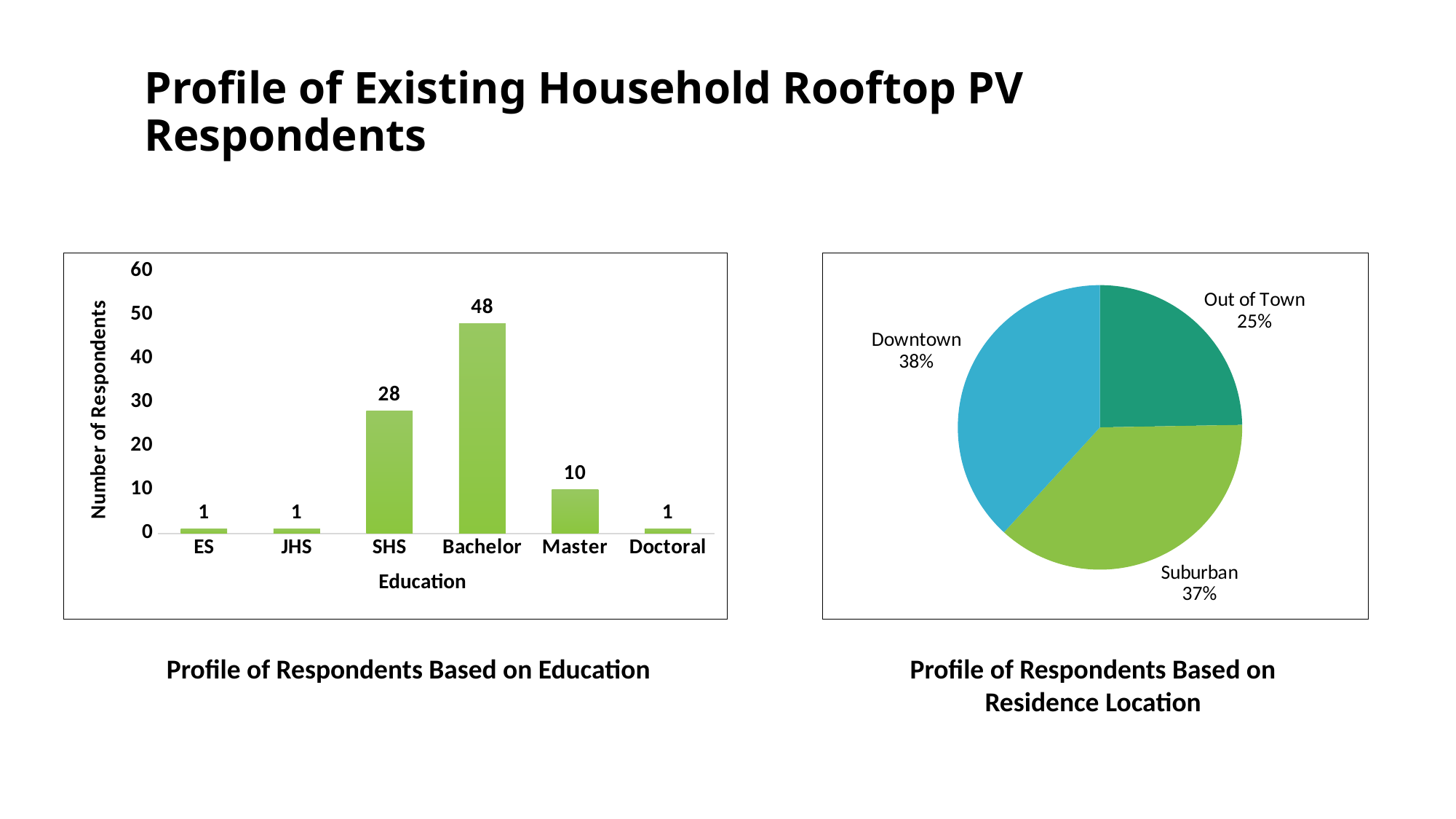
In the 'Profile of Respondents Based on Education' chart, how many respondents have SHS education? 28 In the 'Profile of Respondents Based on Education' chart, how many education categories are shown on the x axis? 6 In the 'Profile of Respondents Based on Residence Location' chart, which residence location has the smallest share? Out of Town What kind of chart is 'Profile of Respondents Based on Education'? Bar chart What kind of chart is 'Profile of Respondents Based on Residence Location'? Pie chart In the 'Profile of Respondents Based on Residence Location' chart, what share of respondents live Downtown? 38% In the 'Profile of Respondents Based on Education' chart, which education level has the highest number of respondents? Bachelor In the 'Profile of Respondents Based on Education' chart, what is the label of the y axis? Number of Respondents In the 'Profile of Respondents Based on Education' chart, how many respondents have a Bachelor degree? 48 In the 'Profile of Respondents Based on Education' chart, which has more respondents, Master or SHS? SHS In the 'Profile of Respondents Based on Education' chart, what is the difference between the number of Bachelor and SHS respondents? 20 In the 'Profile of Respondents Based on Residence Location' chart, what share of respondents live Out of Town? 25%